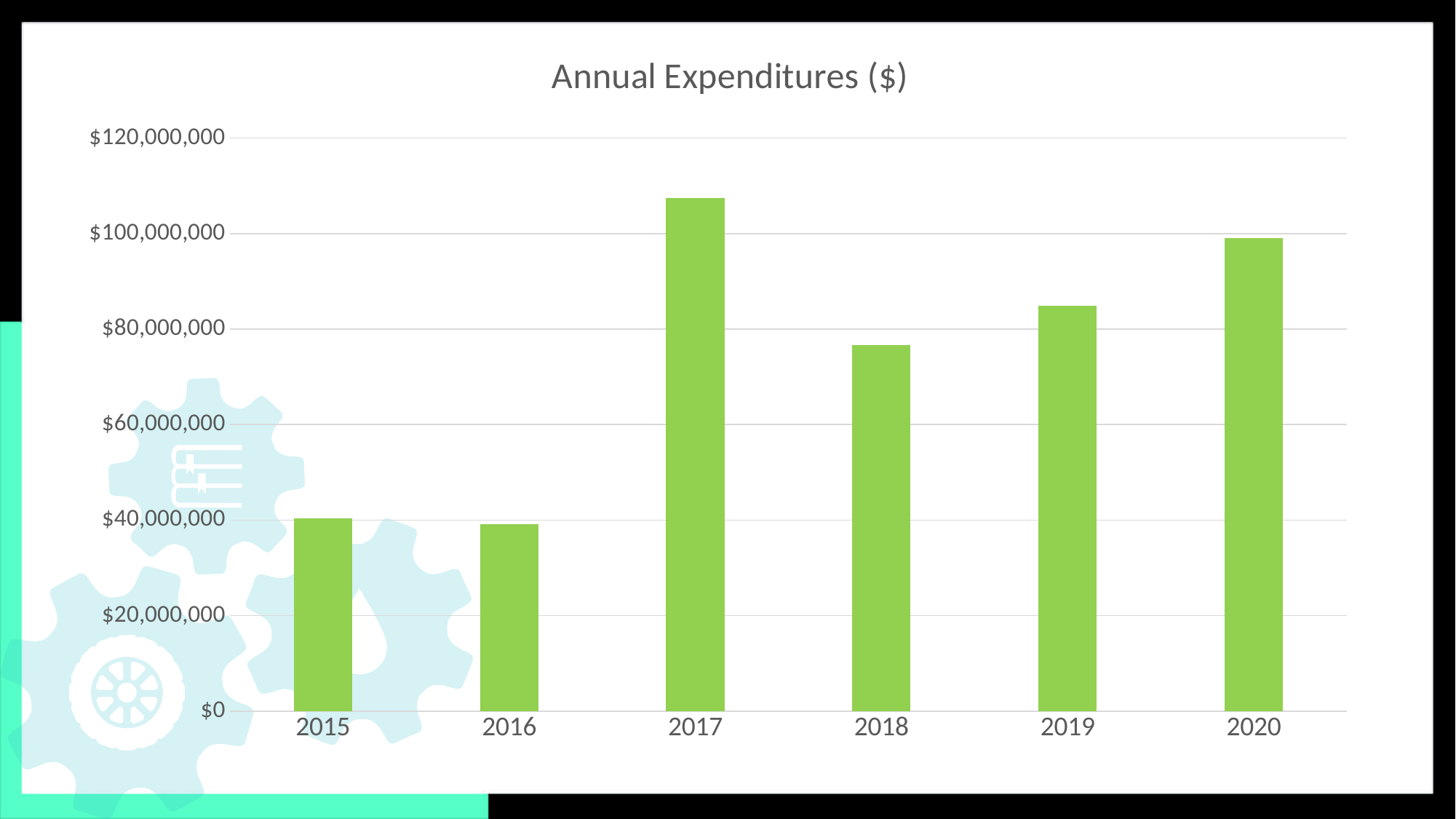
What is the title of the chart? Annual Expenditures ($) Which year has the highest annual expenditure? 2017 What colour are the bars in the chart? green Is the value for 2018 greater or less than $80,000,000? less Is the value for 2015 greater or less than $20,000,000? greater Do the expenditures rise or fall from 2018 to 2020? rise Which year has the larger expenditure, 2018 or 2019? 2019 Which year has the larger expenditure, 2017 or 2020? 2017 Is the value for 2019 greater or less than $80,000,000? greater How many years are shown on the x axis of the chart? 6 What type of chart is shown on the slide? bar chart